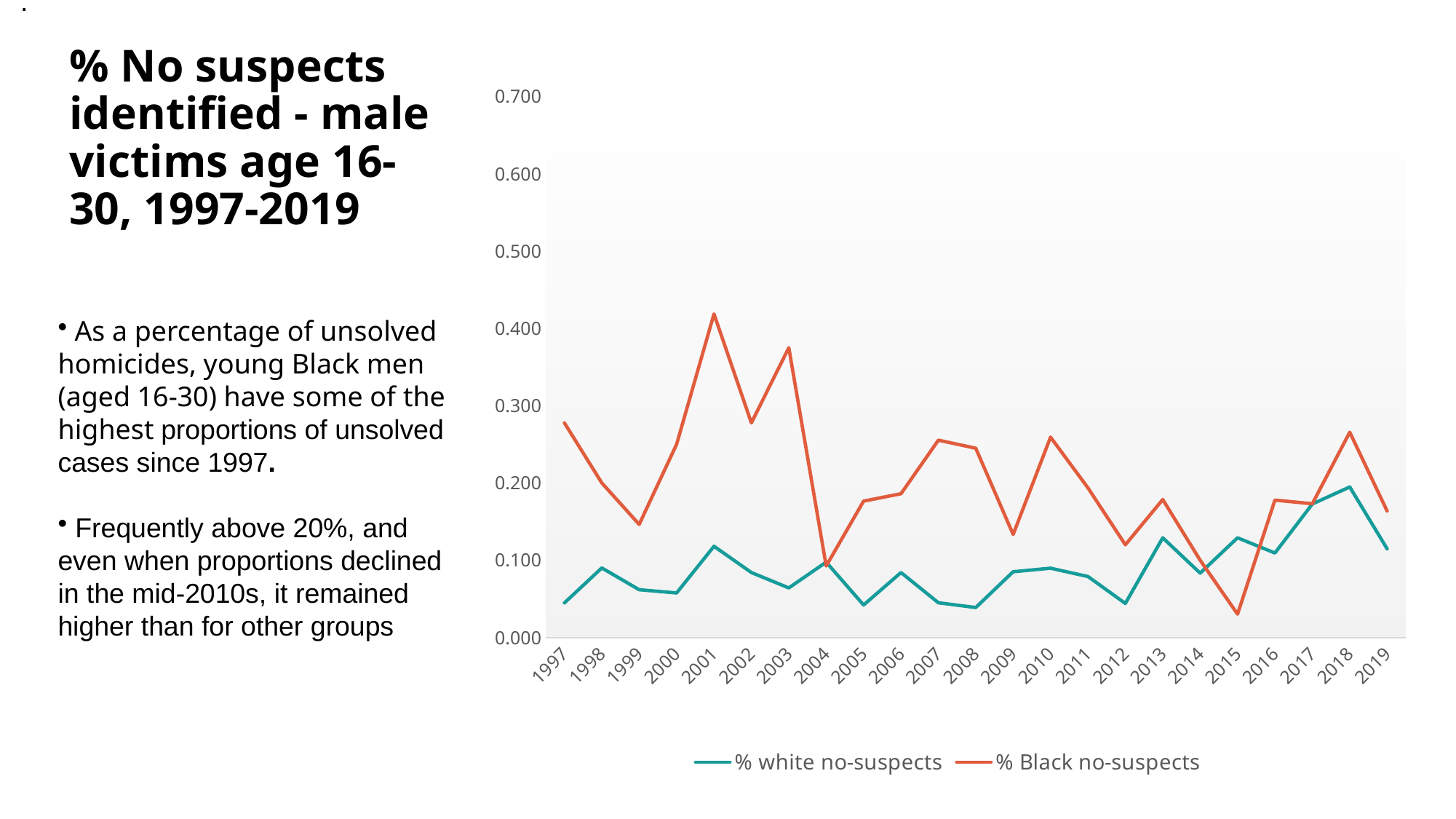
In 2015, which series has the larger value, % white no-suspects or % Black no-suspects? % white no-suspects Does the % Black no-suspects series rise or fall from 2001 to 2004? fall In which year does the % Black no-suspects series reach its highest value? 2001 Is the value for % Black no-suspects in 2001 greater or less than 0.300? greater What kind of chart is shown on the slide? line chart In which year does the % Black no-suspects series reach its lowest value? 2015 How many years are plotted along the x axis? 23 What colour is the line for % Black no-suspects? orange Is the value for % Black no-suspects in 2009 greater or less than 0.200? less Is the value for % Black no-suspects in 2015 greater or less than 0.100? less How many series does the legend list? 2 In which year does the % white no-suspects series reach its highest value? 2018